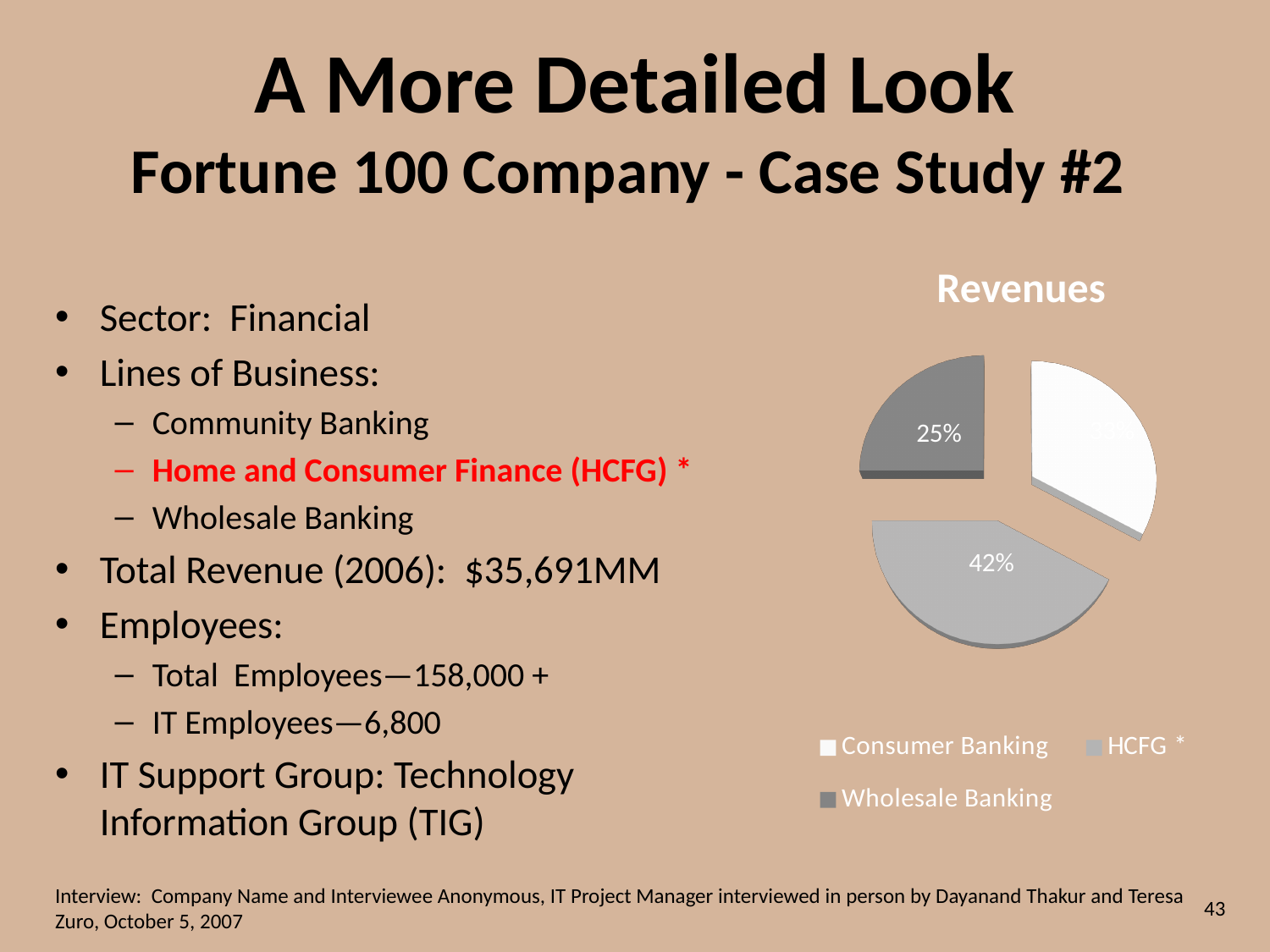
Which line of business has the largest slice in the Revenues pie chart? HCFG * Which slice is larger, HCFG * or Wholesale Banking? HCFG * What percentage of revenues does HCFG * account for in the pie chart? 42% How many entries are listed in the chart's legend? 3 Which line of business has the smallest slice in the Revenues pie chart? Wholesale Banking How many slices does the Revenues pie chart have? 3 What percentage of revenues does Wholesale Banking account for in the pie chart? 25% What kind of chart is shown on the slide? Pie chart What colour is the Consumer Banking slice in the pie chart? White What is the title of the chart? Revenues By how many percentage points does the HCFG * share exceed the Wholesale Banking share? 17 percentage points Which slice is larger, Consumer Banking or Wholesale Banking? Consumer Banking